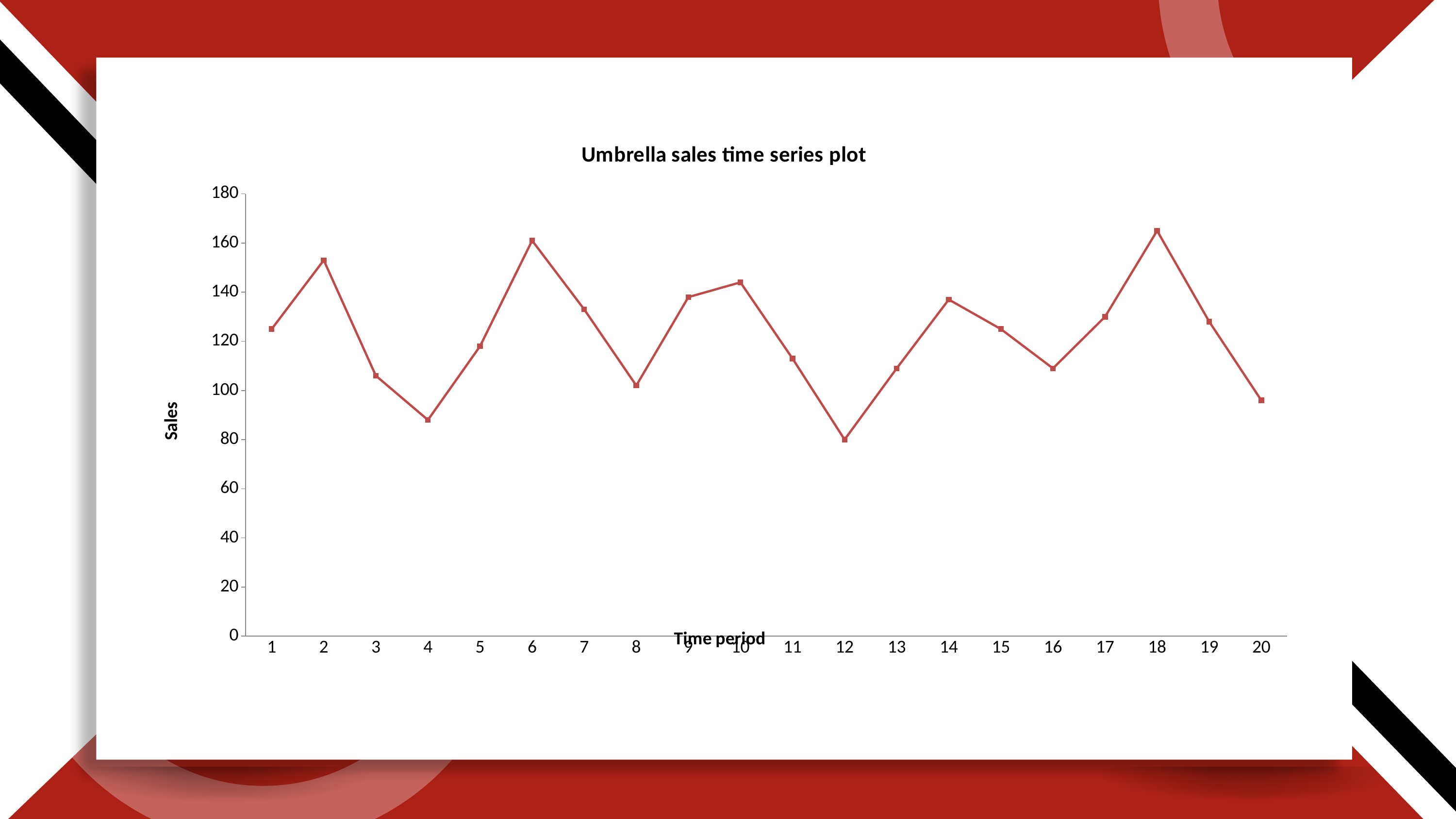
What kind of chart is shown on the slide? line chart Do sales rise or fall from time period 18 to time period 20? fall What is the sales value at time period 12? 80 What is the title of the chart? Umbrella sales time series plot Is the sales value for time period 6 greater or less than 140? greater Which has the larger sales value, time period 2 or time period 3? time period 2 What is the label of the vertical axis? Sales How many time periods are plotted on the chart? 20 Which time period has the lowest sales value? 12 Is the sales value for time period 20 greater or less than 100? less Which time period has the highest sales value? 18 Is the sales value for time period 4 greater or less than 100? less